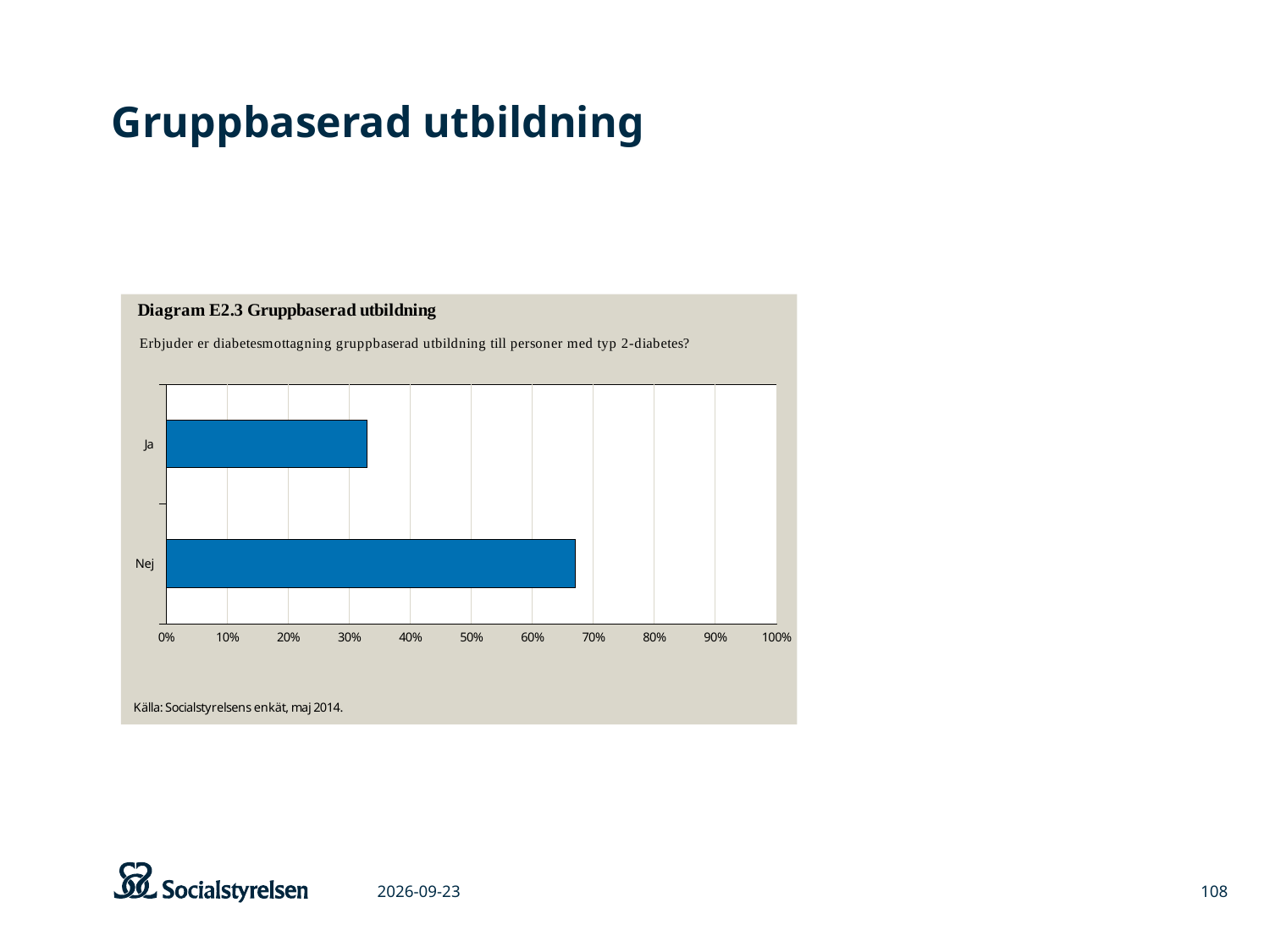
Is the value for Ja greater or less than 20%? greater What kind of chart is shown in Diagram E2.3? bar chart Is the value for Ja greater or less than 40%? less In Diagram E2.3, which is larger, the value for Ja or the value for Nej? Nej Is the value for Nej greater or less than 80%? less How many categories are plotted in Diagram E2.3? 2 What source is cited below the chart? Källa: Socialstyrelsens enkät, maj 2014. Which category has the highest value in Diagram E2.3? Nej What is the title of the chart on the slide? Diagram E2.3 Gruppbaserad utbildning Which category has the lowest value in Diagram E2.3? Ja